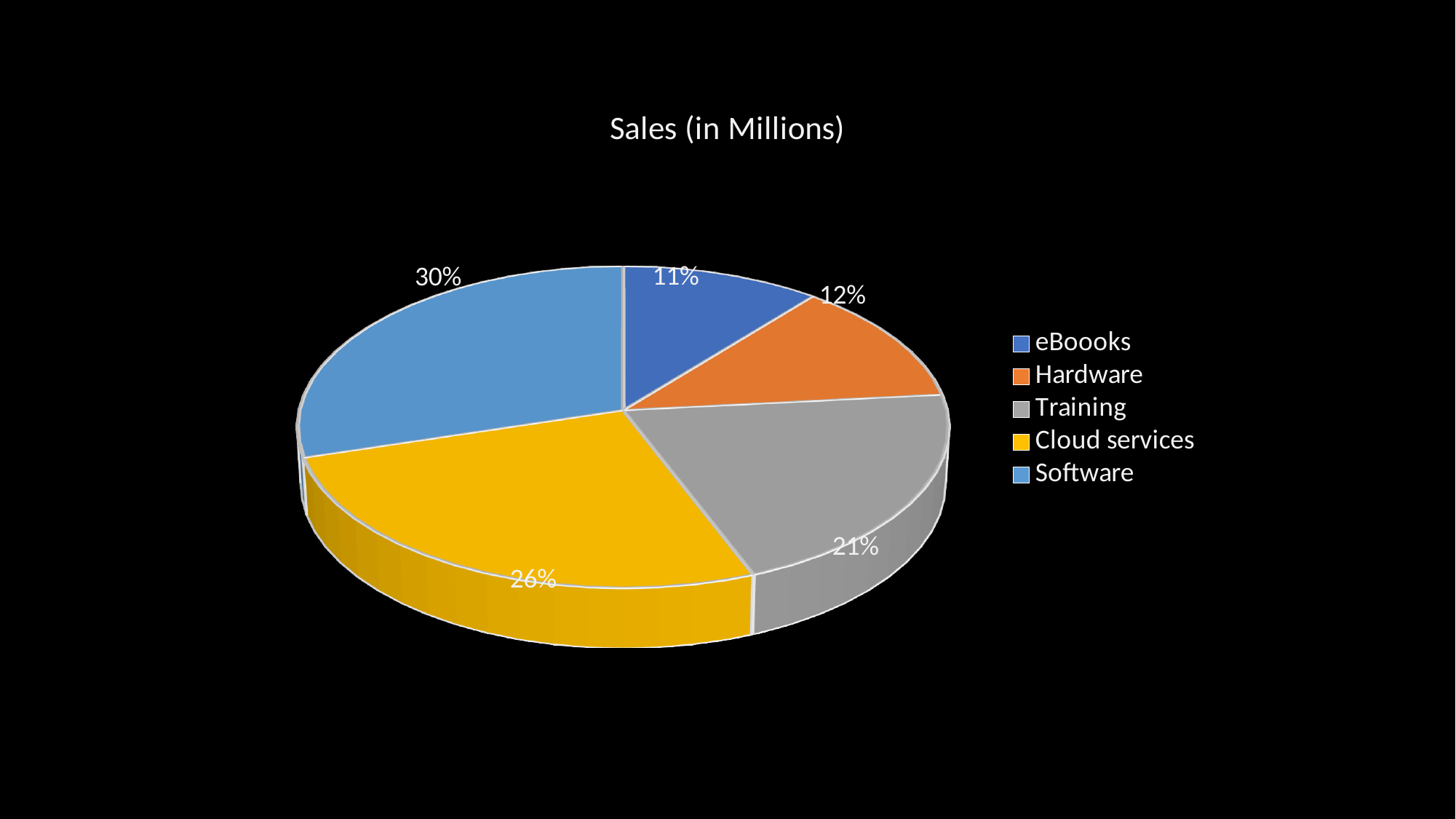
What kind of chart is shown on the slide? Pie chart What share of the pie does eBoooks account for? 11% Which category has the largest slice of the pie? Software What share of the pie does Training account for? 21% What share of the pie does Software account for? 30% Which slice is larger, Cloud services or Training? Cloud services How many categories are shown in the pie chart? 5 Which category has the smallest slice of the pie? eBoooks What is the title of the chart? Sales (in Millions) What is the difference in percentage points between the Software and Training slices? 9